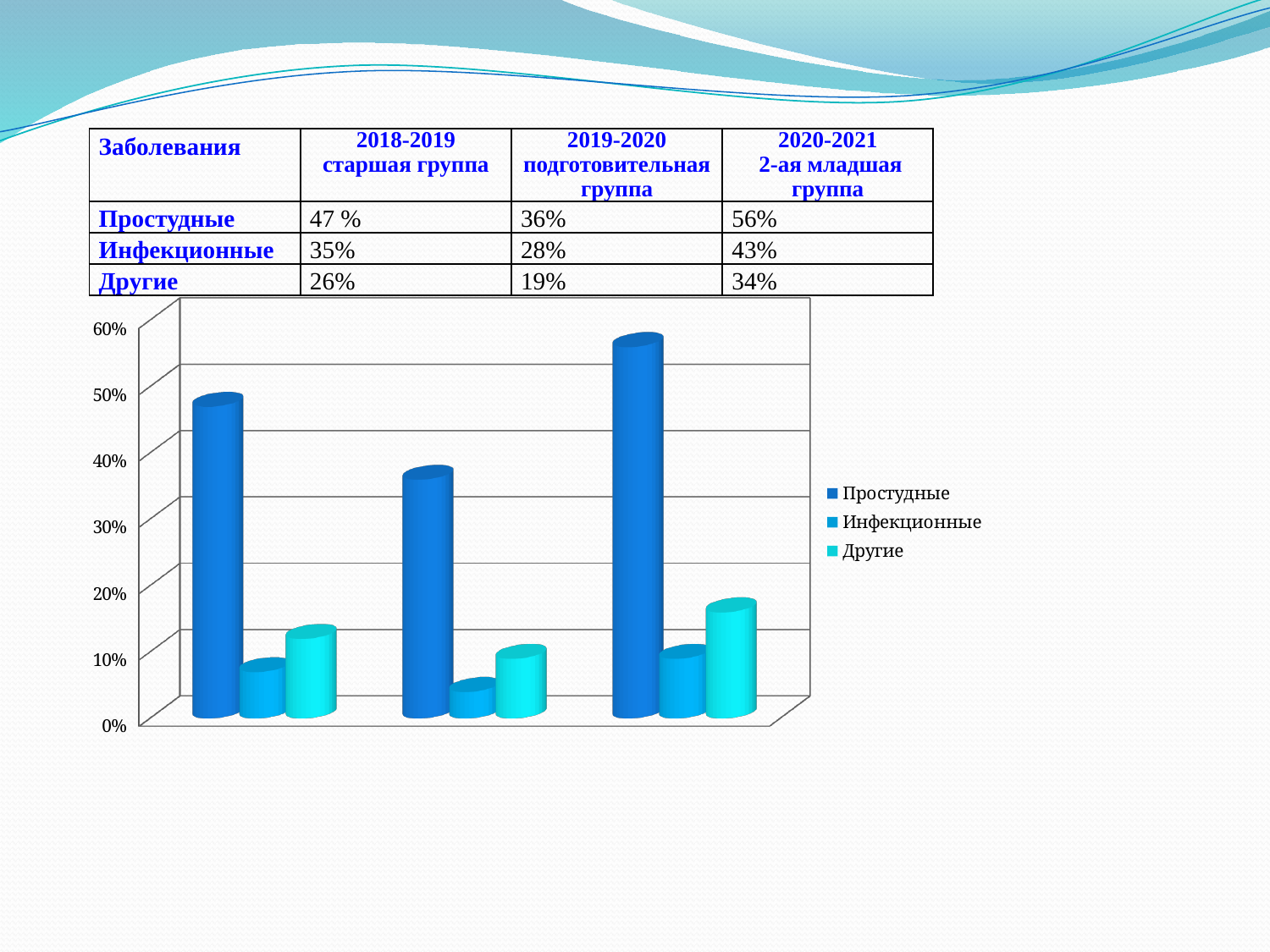
Is the Простудные bar in the first group of bars greater or less than 40%? greater Which series has the tallest bar in the chart? Простудные Is the Простудные bar in the third group of bars greater or less than 50%? greater Is the Другие bar in the third group of bars greater or less than 10%? greater Which series has the shortest bar in the chart? Инфекционные How many groups of bars are plotted in the chart? 3 Which is larger: the Простудные bar in the first group or the Простудные bar in the third group? the third group What kind of chart is shown on the slide? bar chart How many series does the chart legend list? 3 Which series is listed last in the chart legend? Другие